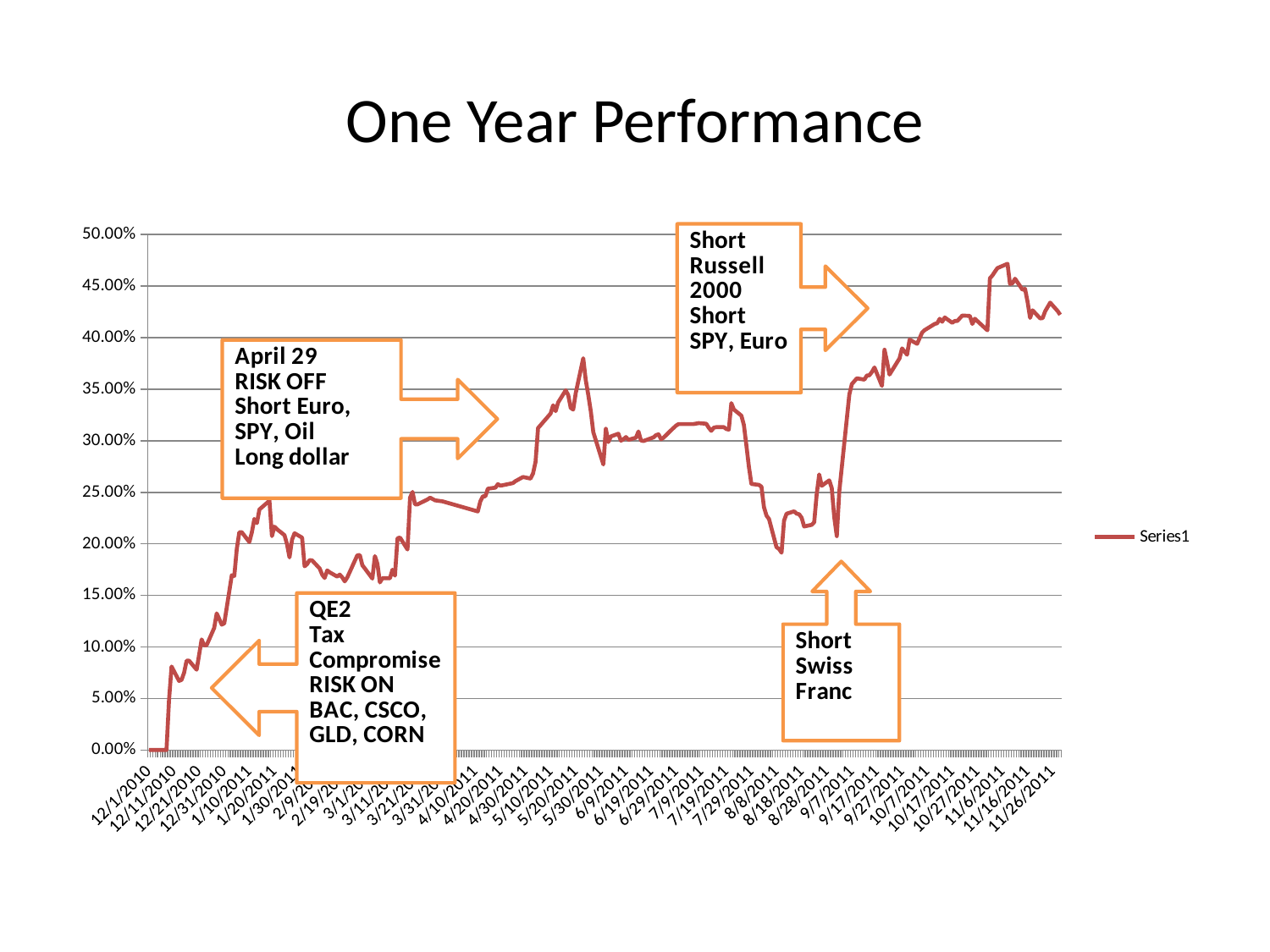
Overall, do the values rise or fall from 12/1/2010 to 11/26/2011? rise What kind of chart is shown on the slide? line chart Which is larger, the value around 11/6/2011 or the value around 8/18/2011? 11/6/2011 What is the name of the series shown in the legend? Series1 Is the value around 1/20/2011 greater or less than 20.00%? greater How many series does the legend list? 1 Is the highest value on the line greater or less than 45.00%? greater Is the value around 8/18/2011 greater or less than 25.00%? less What is the title of the chart? One Year Performance